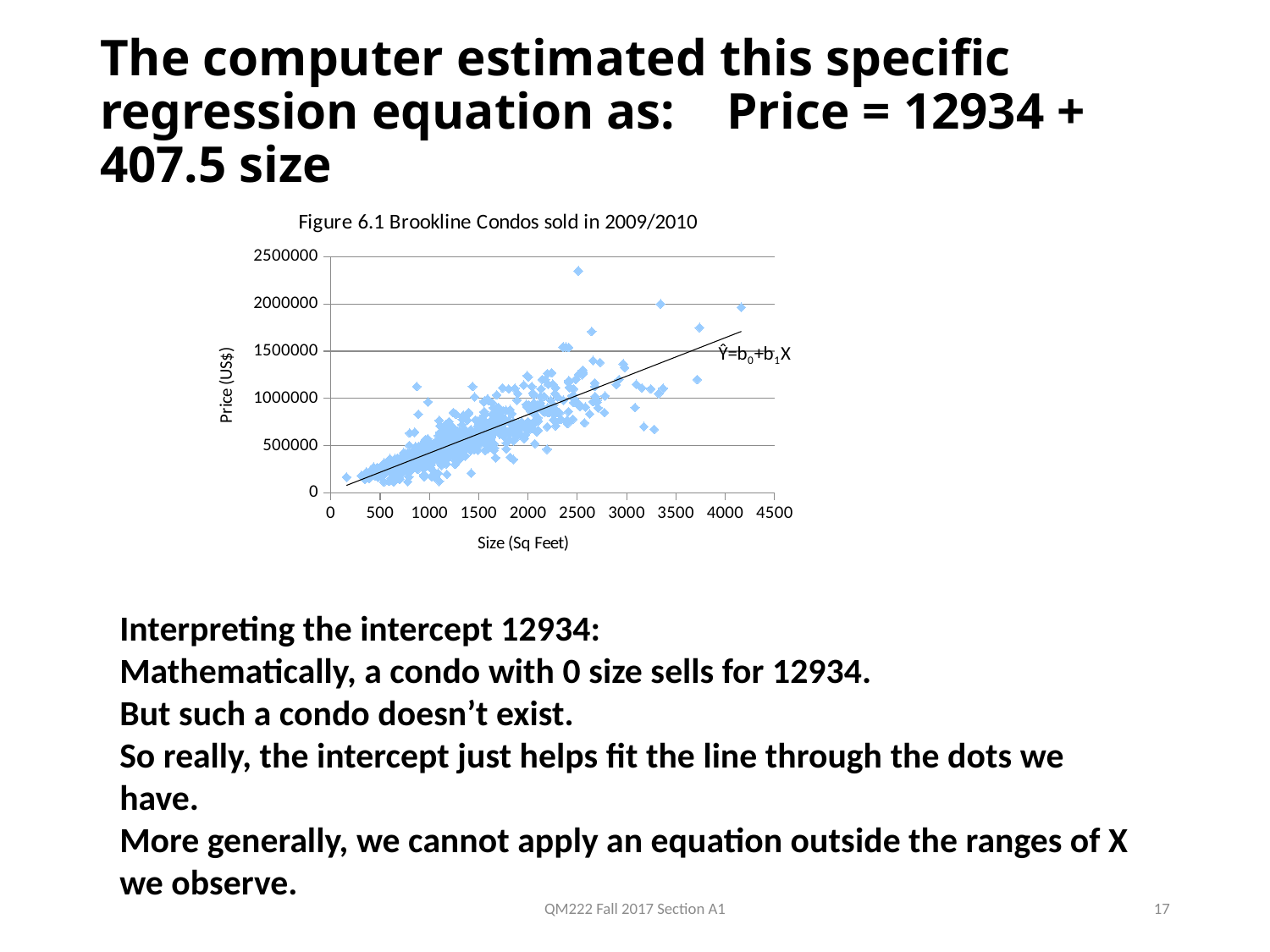
What is the highest tick value shown on the y axis (Price)? 2500000 Do condo prices generally rise or fall as size increases along the x axis? rise What label is written next to the fitted line in the chart? Ŷ=b0+b1X Is the highest plotted price greater or less than 2000000? greater What kind of chart is shown on the slide? scatter plot What is the title of the chart? Figure 6.1 Brookline Condos sold in 2009/2010 Is the lowest plotted price greater or less than 500000? less What is the highest tick value shown on the x axis (Size)? 4500